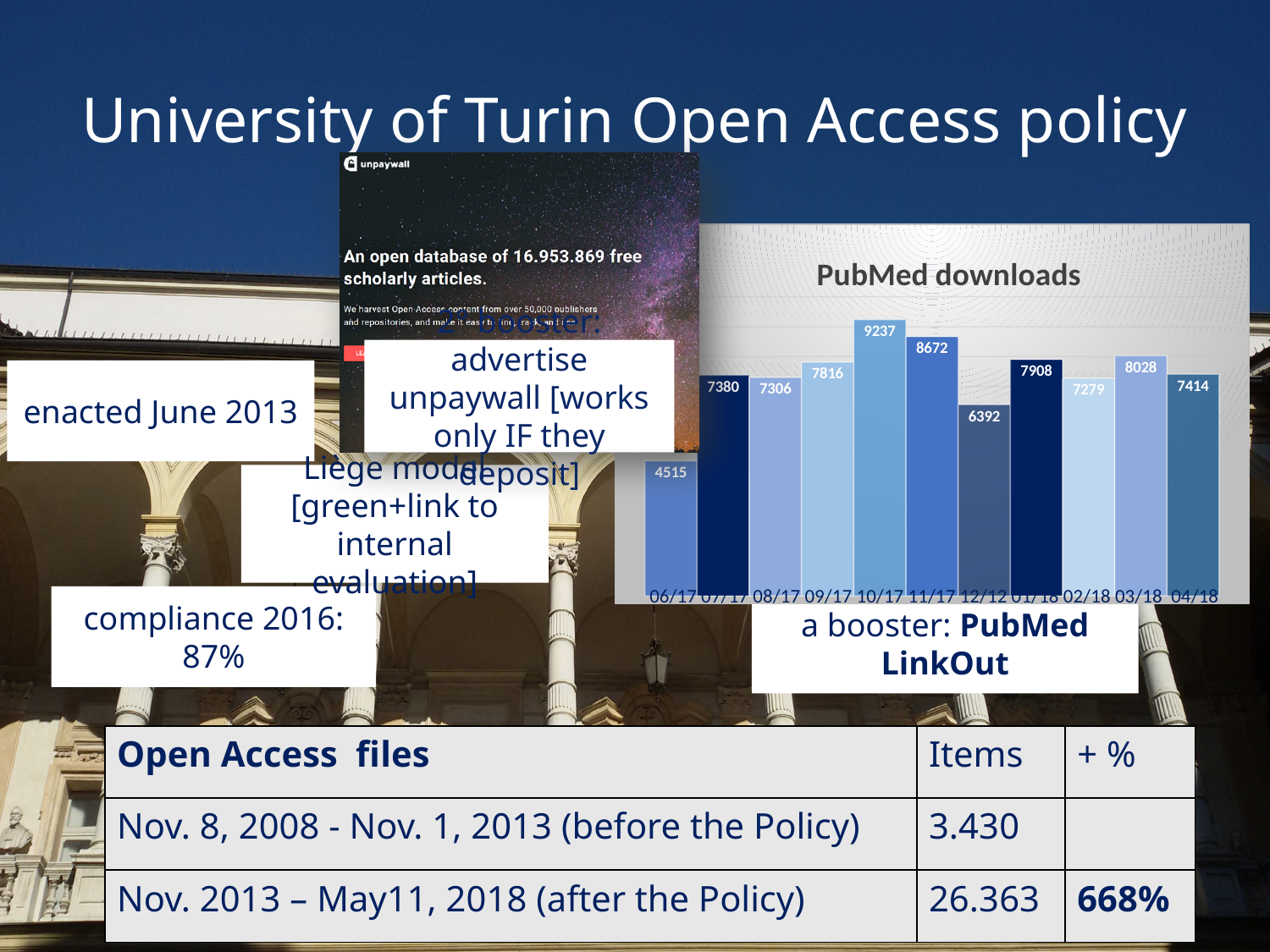
In the PubMed downloads chart, what is the value for 10/17? 9237 In the PubMed downloads chart, what is the lowest value shown? 4515 In the PubMed downloads chart, what is the value for 03/18? 8028 What kind of chart is the PubMed downloads chart? bar chart In the PubMed downloads chart, which is larger, the value for 09/17 or the value for 02/18? 09/17 In the PubMed downloads chart, what is the value for 04/18? 7414 In the PubMed downloads chart, what is the value for 11/17? 8672 In the PubMed downloads chart, what is the difference between the values for 10/17 and 11/17? 565 How many bars are in the PubMed downloads chart? 11 What is the title of the bar chart on the slide? PubMed downloads In the PubMed downloads chart, what is the difference between the values for 01/18 and 02/18? 629 In the PubMed downloads chart, which month has the highest value? 10/17